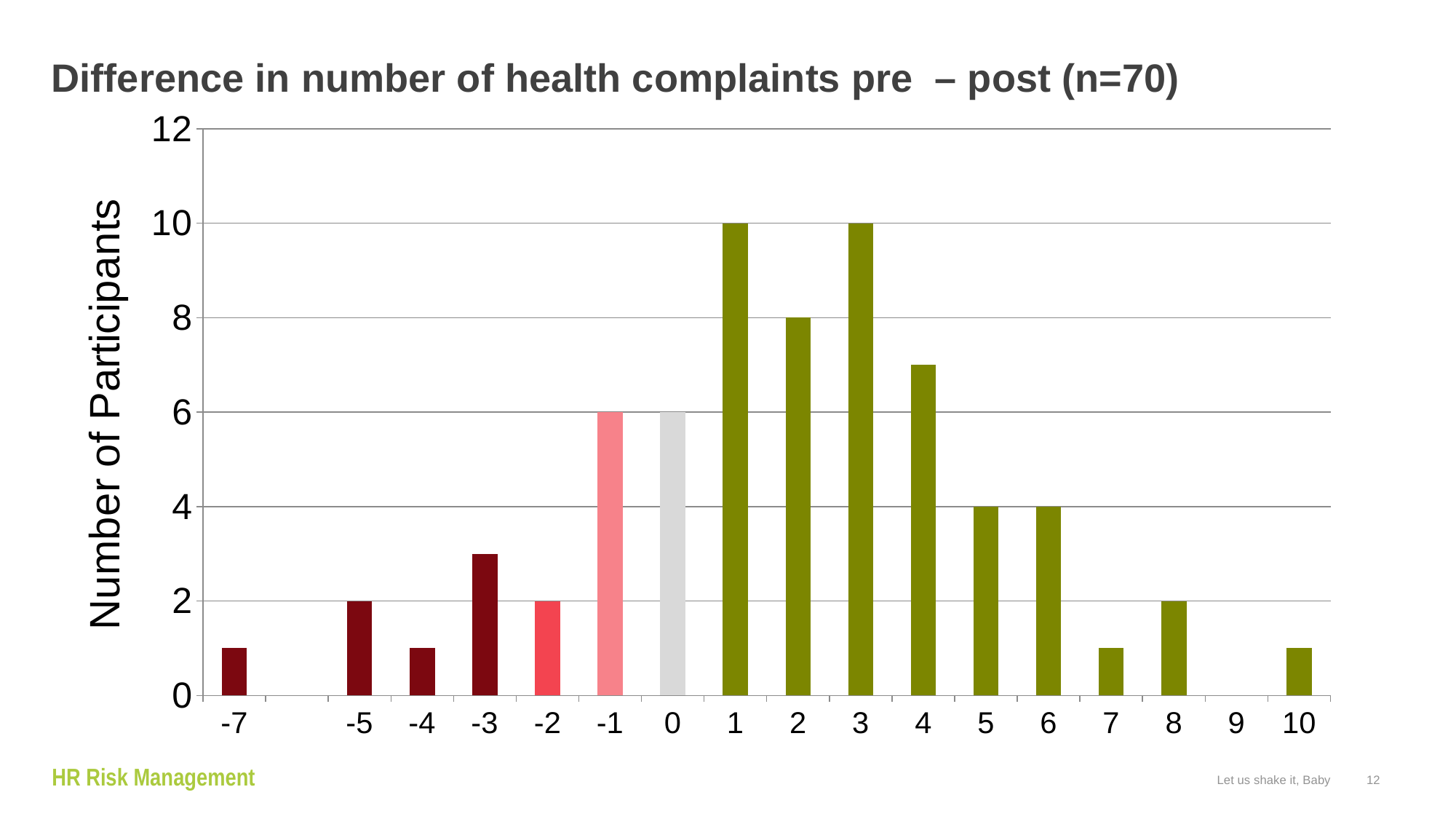
What is the number of participants for a difference of 1? 10 What type of chart is shown on the slide? Bar chart What is the difference between the number of participants at 1 and at 2? 2 Is the number of participants for a difference of -3 greater or less than 4? less Which has more participants, a difference of 2 or a difference of 4? 2 Is the number of participants for a difference of 4 greater or less than 6? greater What is the number of participants for a difference of 2? 8 What is the number of participants for a difference of -1? 6 What is the label of the y-axis? Number of Participants What is the number of participants for a difference of 0? 6 What is the number of participants for a difference of 5? 4 Which x-axis category has no bar at all? 9